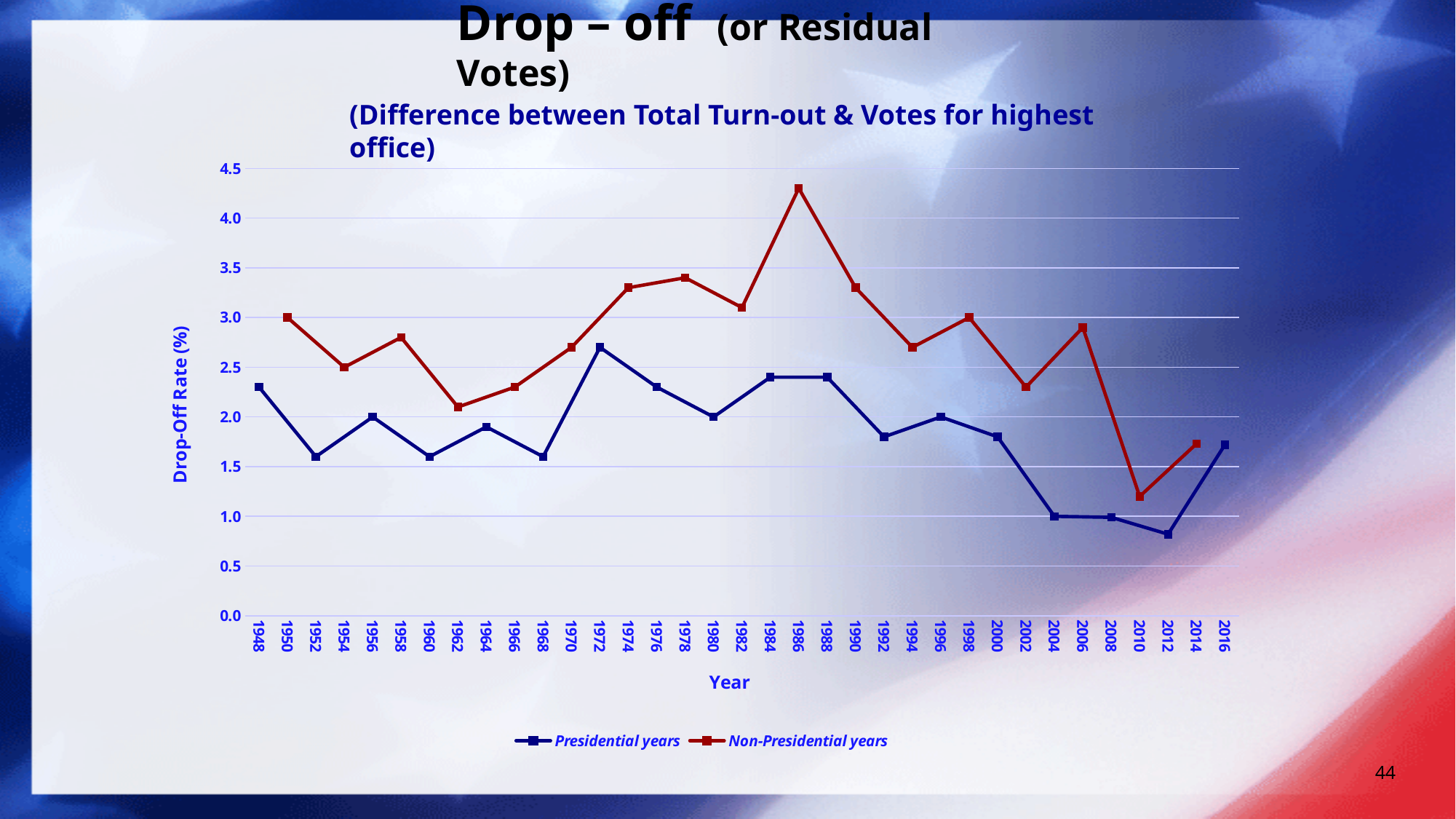
What is the label on the vertical axis? Drop-Off Rate (%) In which year does the Non-Presidential years series reach its lowest drop-off rate? 2010 What kind of chart is shown on the slide? line chart What are the two series named in the legend? Presidential years and Non-Presidential years Which is larger: the Presidential years value for 1972 or the Non-Presidential years value for 1974? Non-Presidential years value for 1974 How many series does the legend list? 2 In which year does the Presidential years series reach its lowest drop-off rate? 2012 Does the Presidential years series rise or fall from 1996 to 2012? fall In which year does the Presidential years series reach its highest drop-off rate? 1972 Is the Presidential years value for 2012 greater or less than 1.0? less Is the Non-Presidential years value for 1986 greater or less than 4.0? greater In which year does the Non-Presidential years series reach its highest drop-off rate? 1986